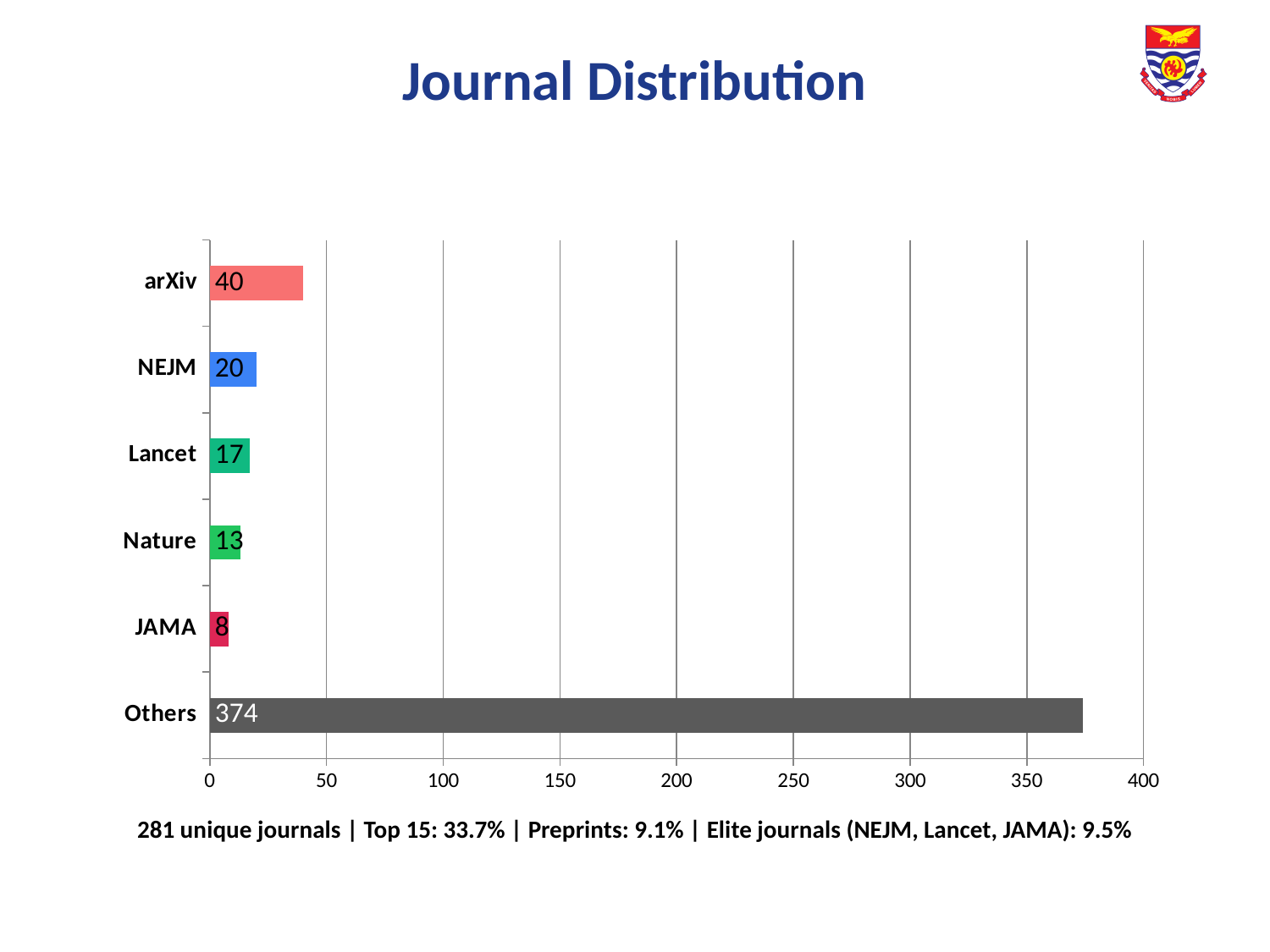
Which category has the lowest value? JAMA What is the value for Others? 374 Is the value for Others greater or less than 350? greater Which category has the highest value? Others What is the title of the chart? Journal Distribution What kind of chart is shown on the slide? bar chart Which is larger, the value for Nature or the value for Lancet? Lancet What is the difference between the values for NEJM and JAMA? 12 What is the difference between the values for arXiv and NEJM? 20 What is the value for Lancet? 17 What is the value for arXiv? 40 How many categories are shown in the chart? 6